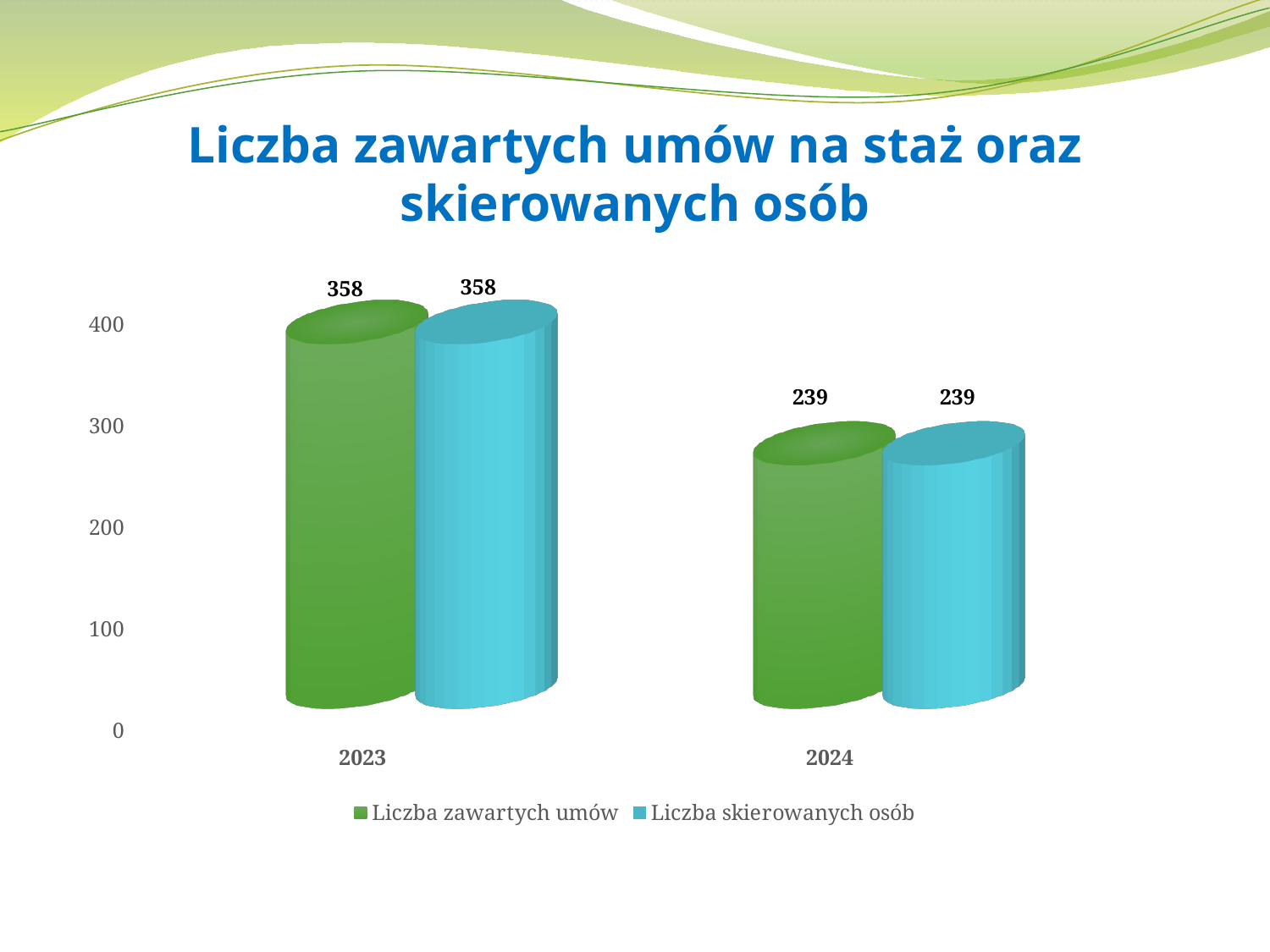
What is the value of Liczba zawartych umów for 2023? 358 What is the value of Liczba skierowanych osób for 2023? 358 Do the values for Liczba zawartych umów rise or fall from 2023 to 2024? Fall How many years are shown on the x axis? 2 What is the value of Liczba zawartych umów for 2024? 239 Is Liczba skierowanych osób larger in 2023 or in 2024? 2023 How many series does the legend list? 2 Which year has the lowest value for Liczba skierowanych osób? 2024 What kind of chart is shown on the slide? Bar chart Which year has the highest value for Liczba zawartych umów? 2023 What is the difference between Liczba zawartych umów in 2023 and in 2024? 119 What is the value of Liczba skierowanych osób for 2024? 239